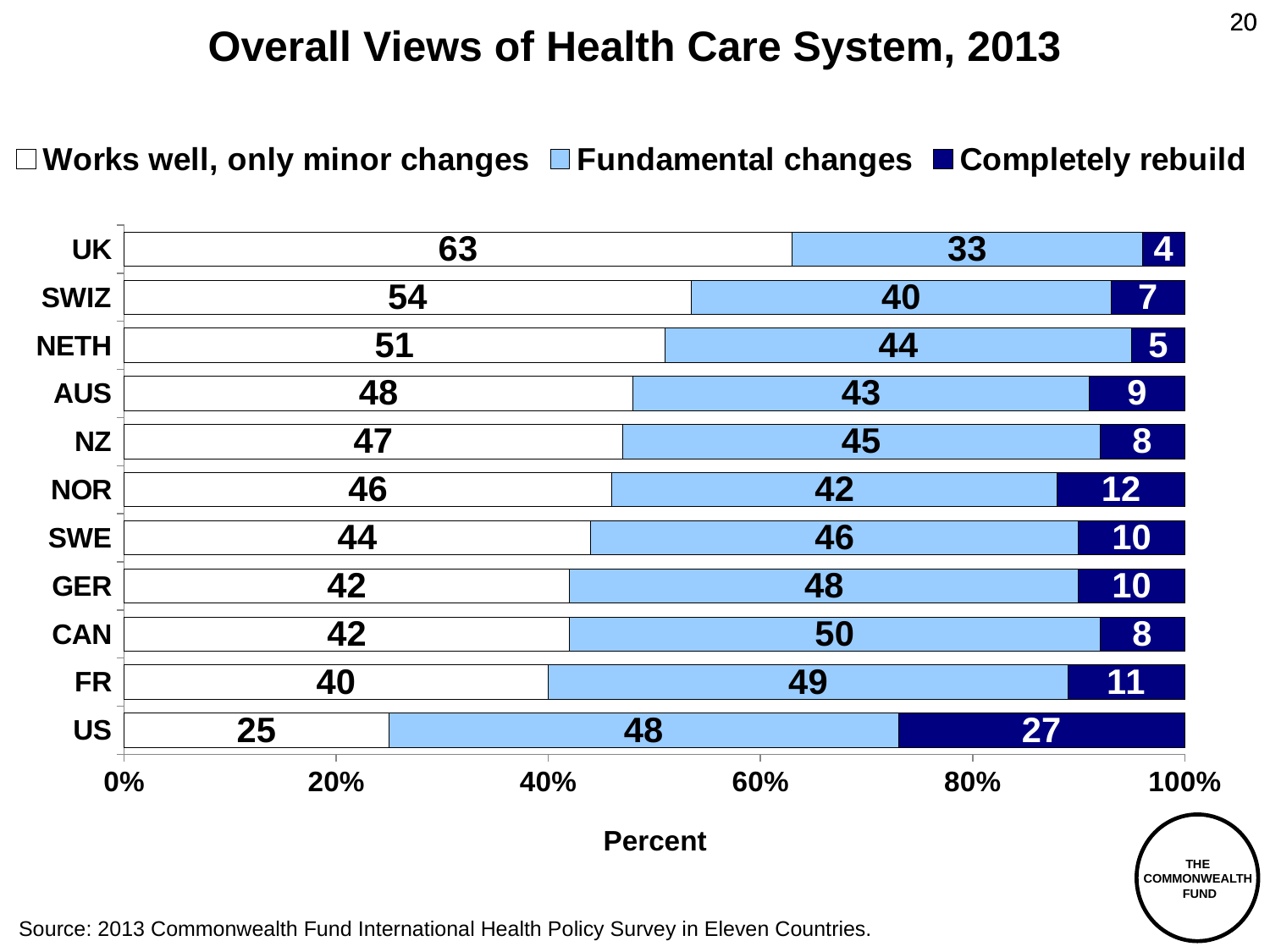
How many countries are shown in the chart? 11 How many series does the legend list? 3 What kind of chart is shown on the slide? Stacked bar chart Which country has the lowest 'Works well, only minor changes' value? US What is the total of the three segments for the NOR bar? 100 Which country has the highest 'Works well, only minor changes' value? UK What is the 'Fundamental changes' value for CAN? 50 Which country has the lowest 'Completely rebuild' value? UK What percentage of UK respondents said the health care system works well with only minor changes? 63 What is the difference between the 'Works well, only minor changes' values for UK and US? 38 Which is larger: the 'Fundamental changes' value for GER or for NOR? GER What is the 'Completely rebuild' value for the US? 27